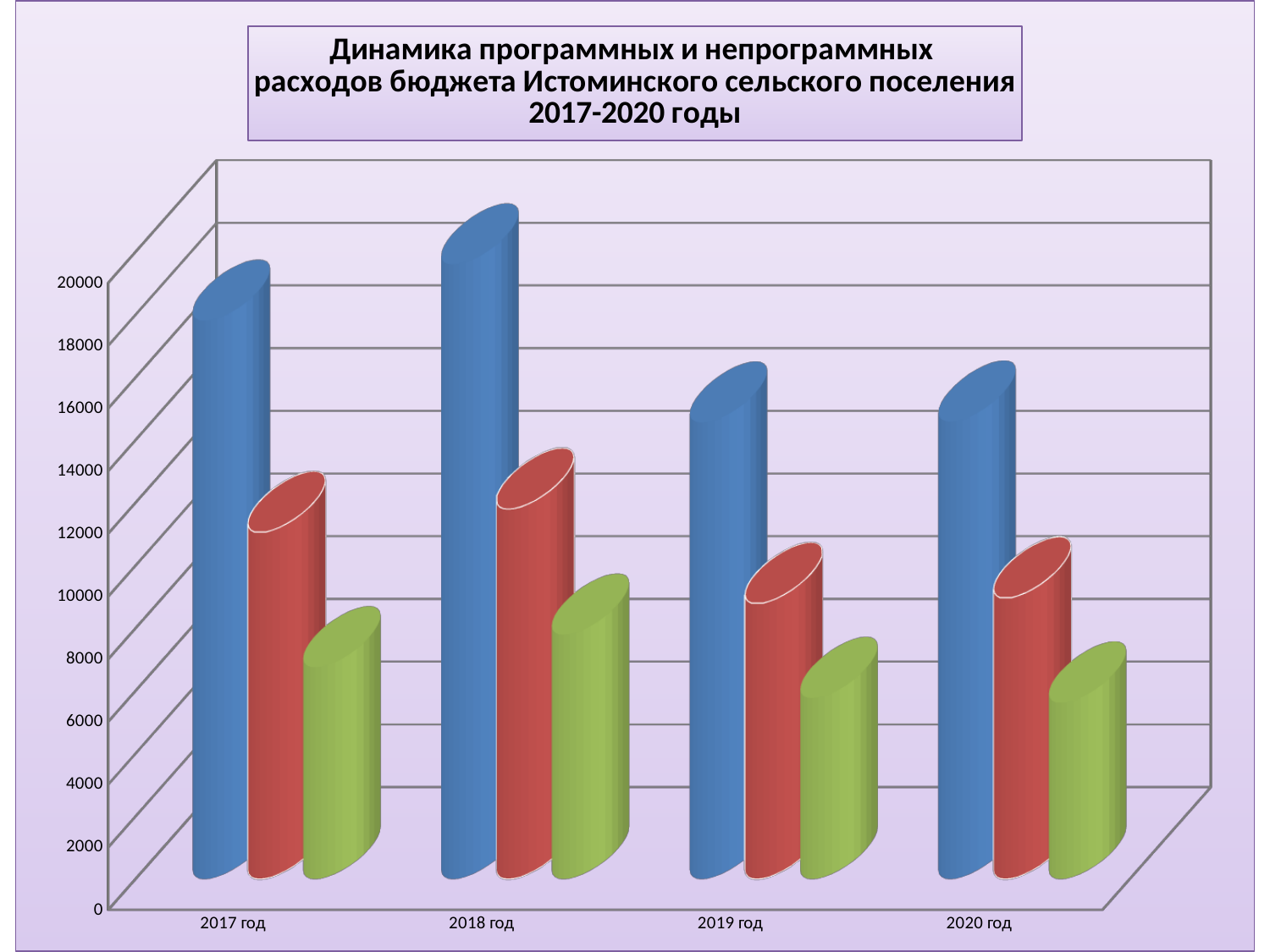
In which year is the blue bar the tallest? 2018 год Is the green bar for 2019 год greater or less than 10000? less How many bars are plotted for each year? 3 How many year categories are shown on the x axis? 4 What kind of chart is shown on the slide? Bar chart Which is larger, the blue bar for 2017 год or the blue bar for 2018 год? 2018 год Does the blue bar rise or fall from 2018 год to 2019 год? fall Which is larger, the red bar for 2018 год or the red bar for 2019 год? 2018 год Is the red bar for 2017 год greater or less than 10000? greater Is the blue bar for 2019 год greater or less than 12000? greater In which year is the green bar the tallest? 2018 год